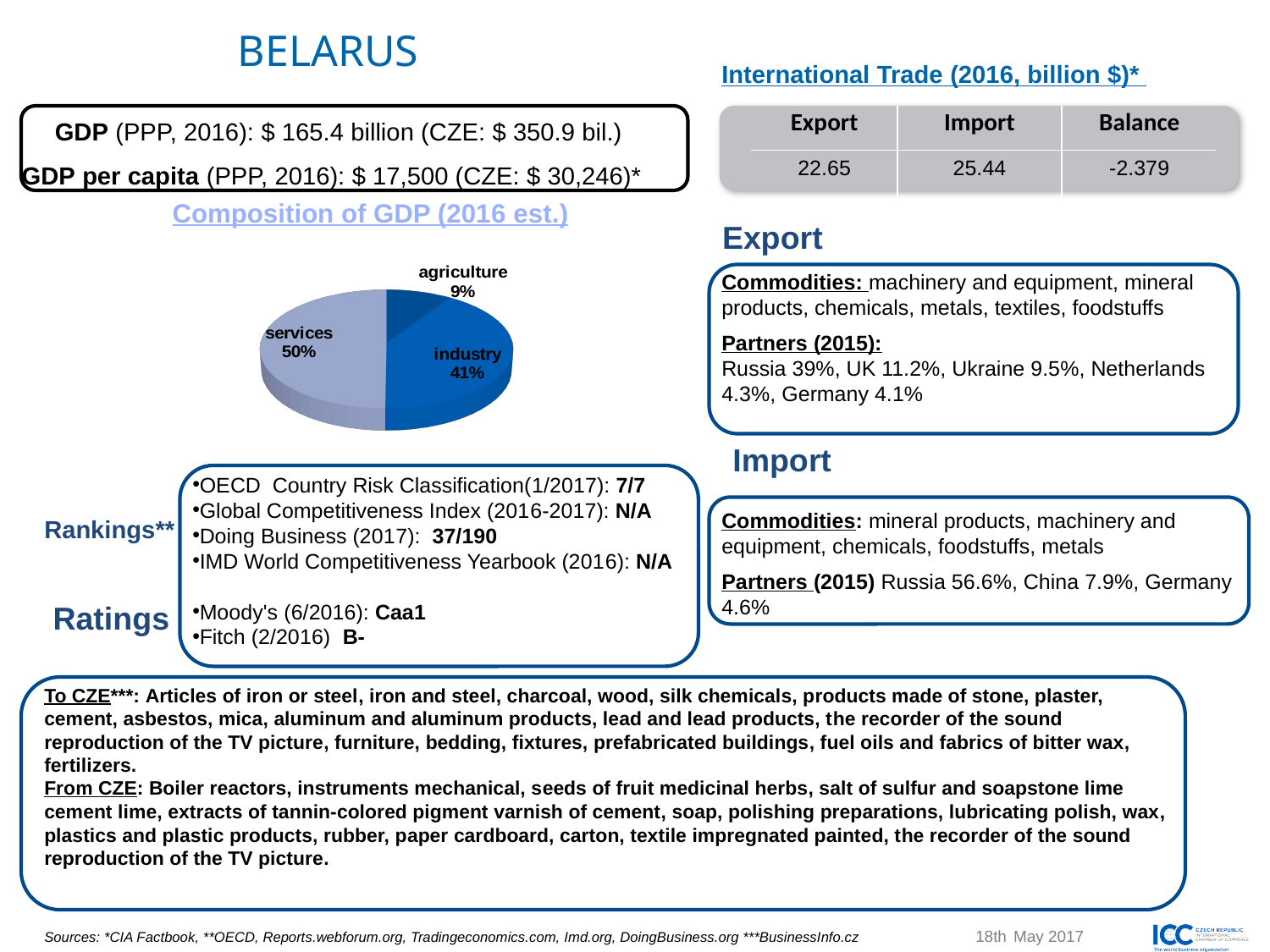
What is the title of the pie chart on the slide? Composition of GDP (2016 est.) Which sector has the largest share in the Composition of GDP pie chart? services What share of GDP does services account for in the Composition of GDP pie chart? 50% Which sector has the smallest share in the Composition of GDP pie chart? agriculture What kind of chart is used to show the Composition of GDP (2016 est.)? pie chart In the Composition of GDP pie chart, which is larger: services or industry? services In the Composition of GDP pie chart, what is the difference in percentage points between services and industry? 9 In the Composition of GDP pie chart, which is larger: industry or agriculture? industry In the Composition of GDP pie chart, what is the difference in percentage points between industry and agriculture? 32 What share of GDP does industry account for in the Composition of GDP pie chart? 41% What share of GDP does agriculture account for in the Composition of GDP pie chart? 9% How many sectors are shown in the Composition of GDP pie chart? 3